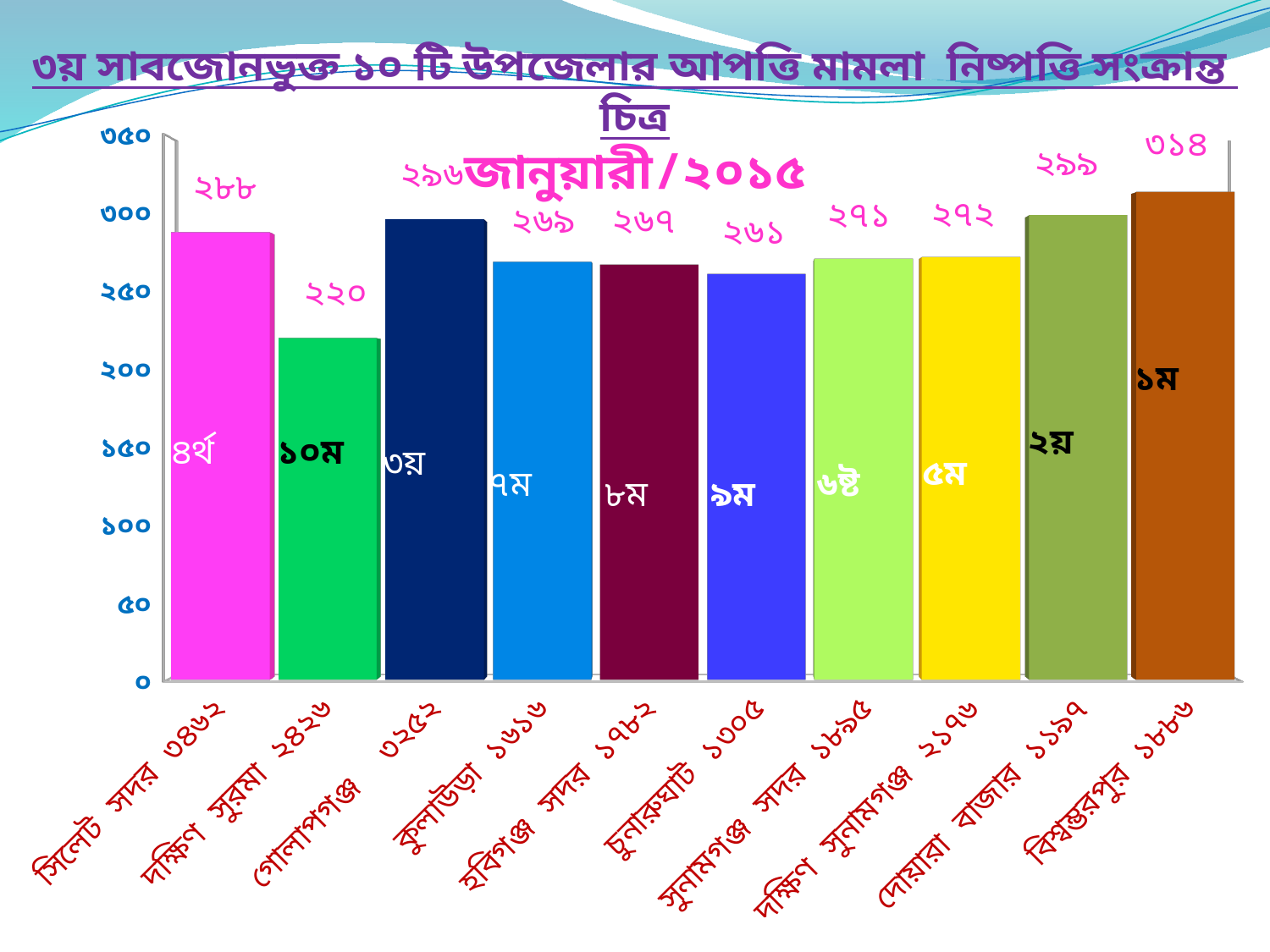
What is the value shown for সিলেট সদর ৩৪৬২? ২৮৮ How many upazila categories are plotted in the chart? ১০ Is the value for চুনারুঘাট ১৩০৫ greater or less than ২৫০? greater What rank label is printed inside the bar for বিশ্বম্ভরপুর ১৮৮৬? ১ম What is the value shown for দক্ষিণ সুরমা ২৪২৬? ২২০ What type of chart is shown on the slide? bar chart What is the difference between the values for বিশ্বম্ভরপুর ১৮৮৬ and দক্ষিণ সুরমা ২৪২৬? ৯৪ Which upazila has the highest value in the chart? বিশ্বম্ভরপুর ১৮৮৬ Which has a larger value, সুনামগঞ্জ সদর ১৮৯৫ or দক্ষিণ সুনামগঞ্জ ২১৭৬? দক্ষিণ সুনামগঞ্জ ২১৭৬ What is the value shown for দোয়ারা বাজার ১১৯৭? ২৯৯ What is the value shown for গোলাপগঞ্জ ৩২৫২? ২৯৬ Which upazila has the lowest value in the chart? দক্ষিণ সুরমা ২৪২৬